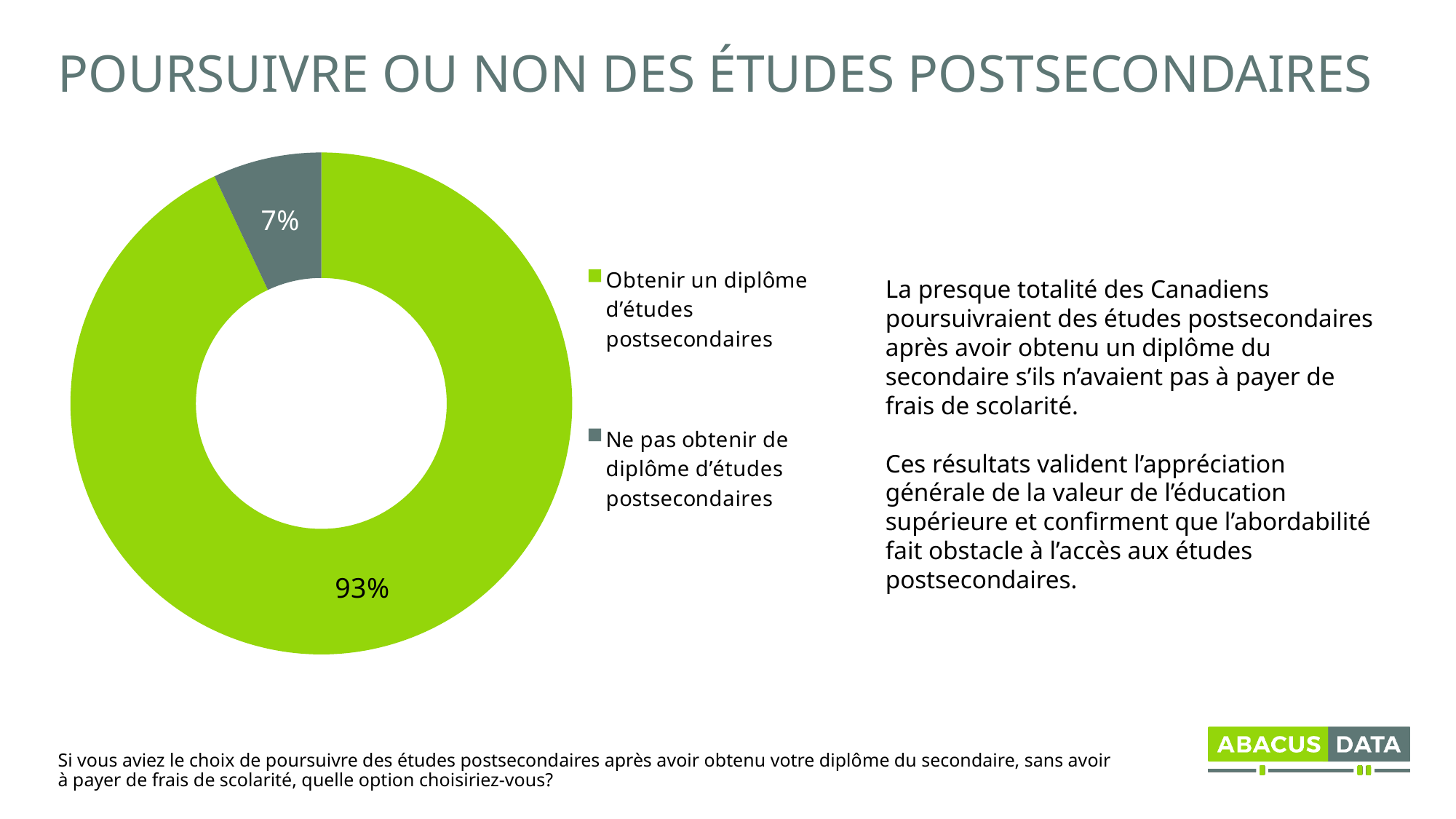
Which is larger: the share for "Obtenir un diplôme d'études postsecondaires" or for "Ne pas obtenir de diplôme d'études postsecondaires"? Obtenir un diplôme d'études postsecondaires What is the difference in percentage points between the two slices? 86 What colour is the slice for "Obtenir un diplôme d'études postsecondaires"? Green How many entries does the legend list? 2 What is the title of the slide? POURSUIVRE OU NON DES ÉTUDES POSTSECONDAIRES What share of the pie does the grey slice represent? 7% What percentage of respondents chose "Obtenir un diplôme d'études postsecondaires"? 93% What kind of chart is shown on the slide? Pie chart (doughnut) Which category has the largest share of the chart? Obtenir un diplôme d'études postsecondaires What percentage of respondents chose "Ne pas obtenir de diplôme d'études postsecondaires"? 7% How many categories are shown in the chart? 2 Which category has the smallest share of the chart? Ne pas obtenir de diplôme d'études postsecondaires